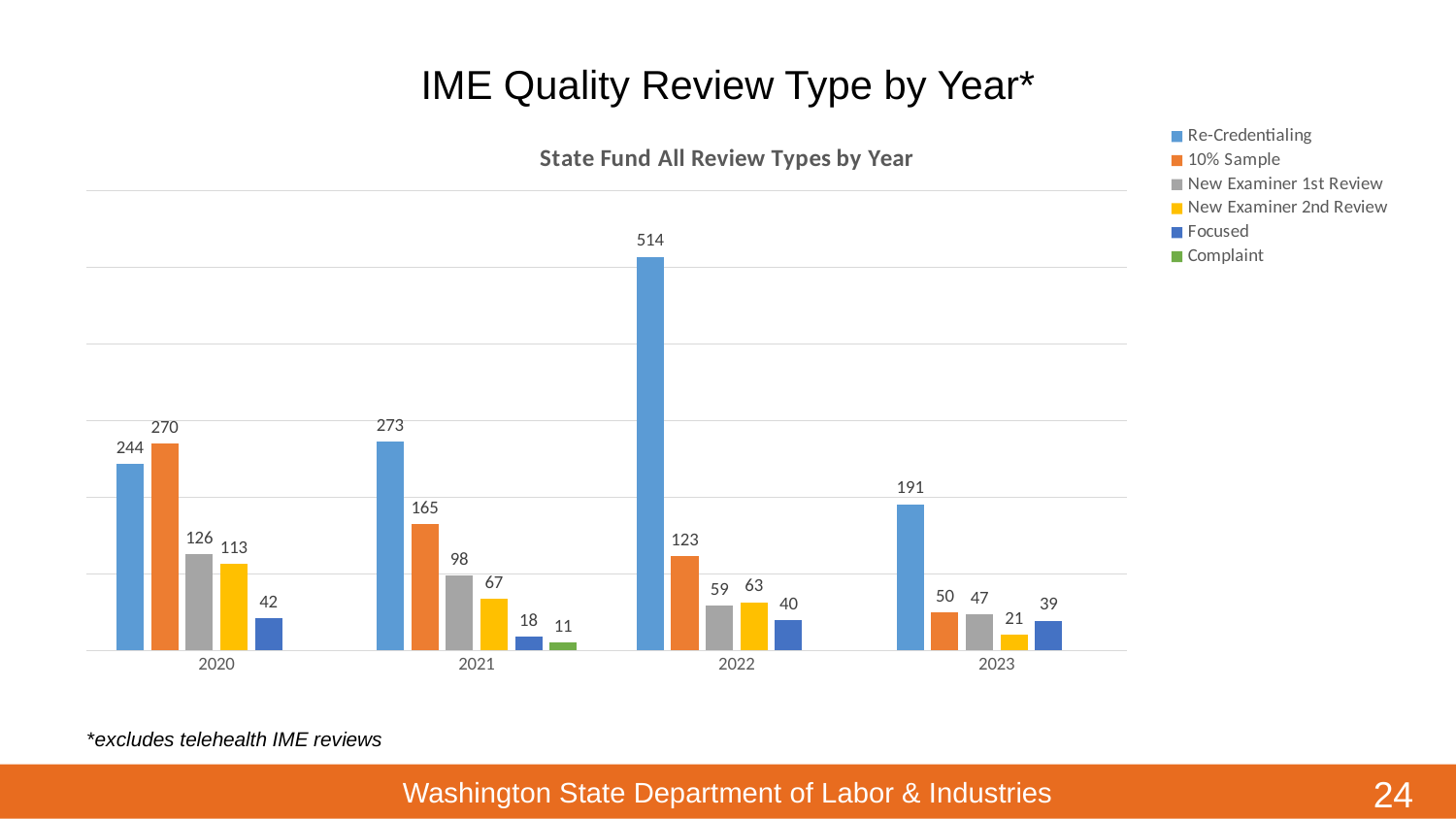
Which is larger in 2020, Re-Credentialing or 10% Sample? 10% Sample How many years are shown on the x axis? 4 What kind of chart is shown? Bar chart How many series does the legend list? 6 In which year is the Focused value lowest? 2021 What is the value for Re-Credentialing in 2022? 514 What is the value for 10% Sample in 2020? 270 In which year is the Re-Credentialing value highest? 2022 Does the 10% Sample value rise or fall from 2020 to 2023? Fall What is the value for Complaint in 2021? 11 What is the difference between the Re-Credentialing values for 2022 and 2023? 323 What is the value for New Examiner 2nd Review in 2023? 21